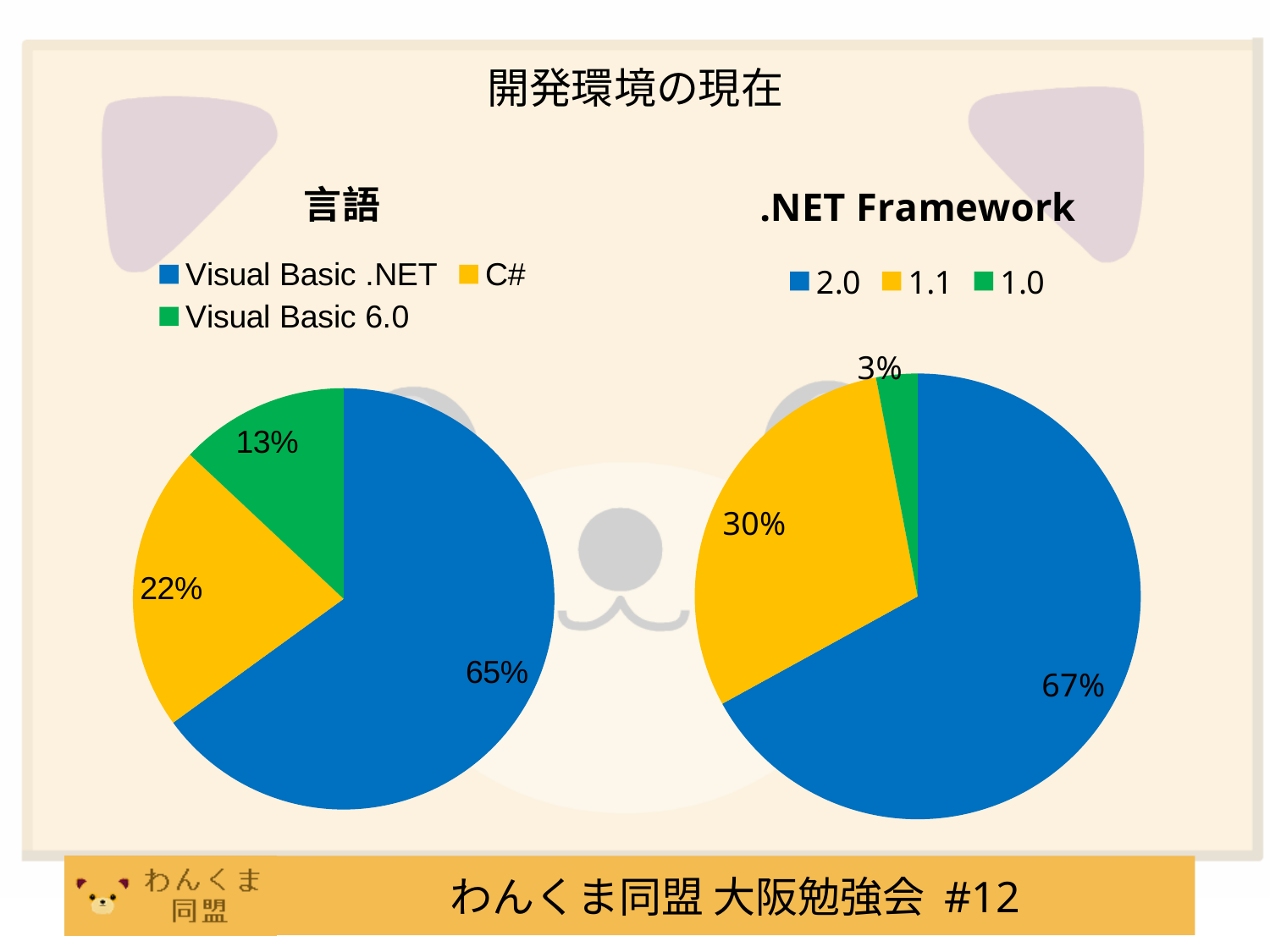
How many categories does the legend of the 言語 chart list? 3 In the 言語 chart, what share does Visual Basic .NET have? 65% What type of chart is the .NET Framework chart? Pie chart In the 言語 chart, what share does C# have? 22% In the .NET Framework chart, which is larger, the share for 1.1 or the share for 1.0? 1.1 In the 言語 chart, which category has the largest share? Visual Basic .NET In the .NET Framework chart, what share does version 2.0 have? 67% In the .NET Framework chart, what share does version 1.1 have? 30% In the 言語 chart, what is the difference in percentage points between Visual Basic .NET and C#? 43 In the 言語 chart, what share does Visual Basic 6.0 have? 13% In the .NET Framework chart, what share does version 1.0 have? 3% In the .NET Framework chart, which version has the smallest share? 1.0